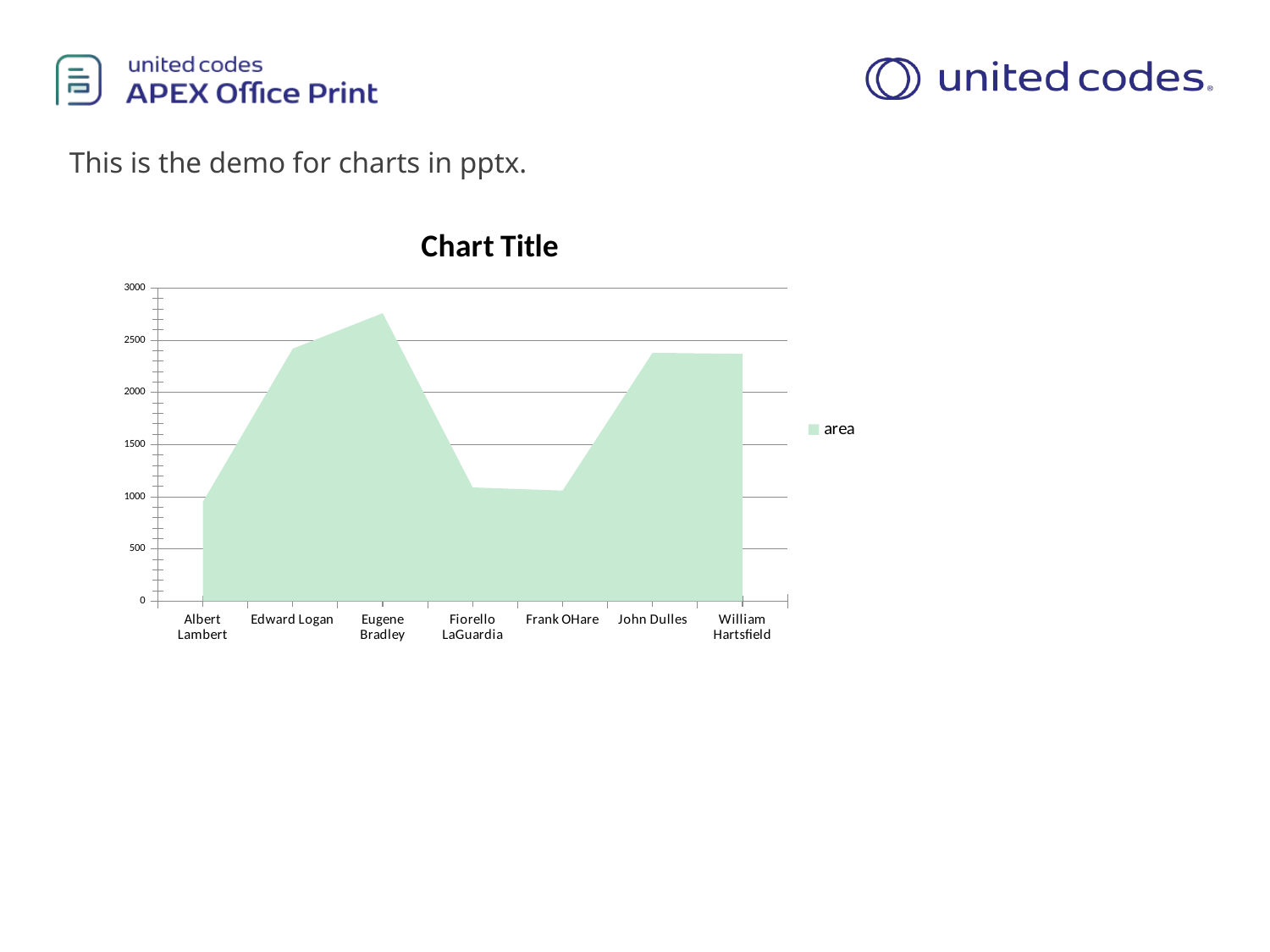
How many categories are plotted along the x axis of the chart? 7 Which has the larger value, Albert Lambert or Edward Logan? Edward Logan Is the value for Fiorello LaGuardia greater or less than 1000? greater Is the value for John Dulles greater or less than 2500? less What is the name of the series shown in the chart's legend? area How many series does the chart's legend list? 1 Is the value for Eugene Bradley greater or less than 2500? greater Which category has the highest value in the chart? Eugene Bradley Which has the larger value, Eugene Bradley or Fiorello LaGuardia? Eugene Bradley What kind of chart is shown on the slide? area chart